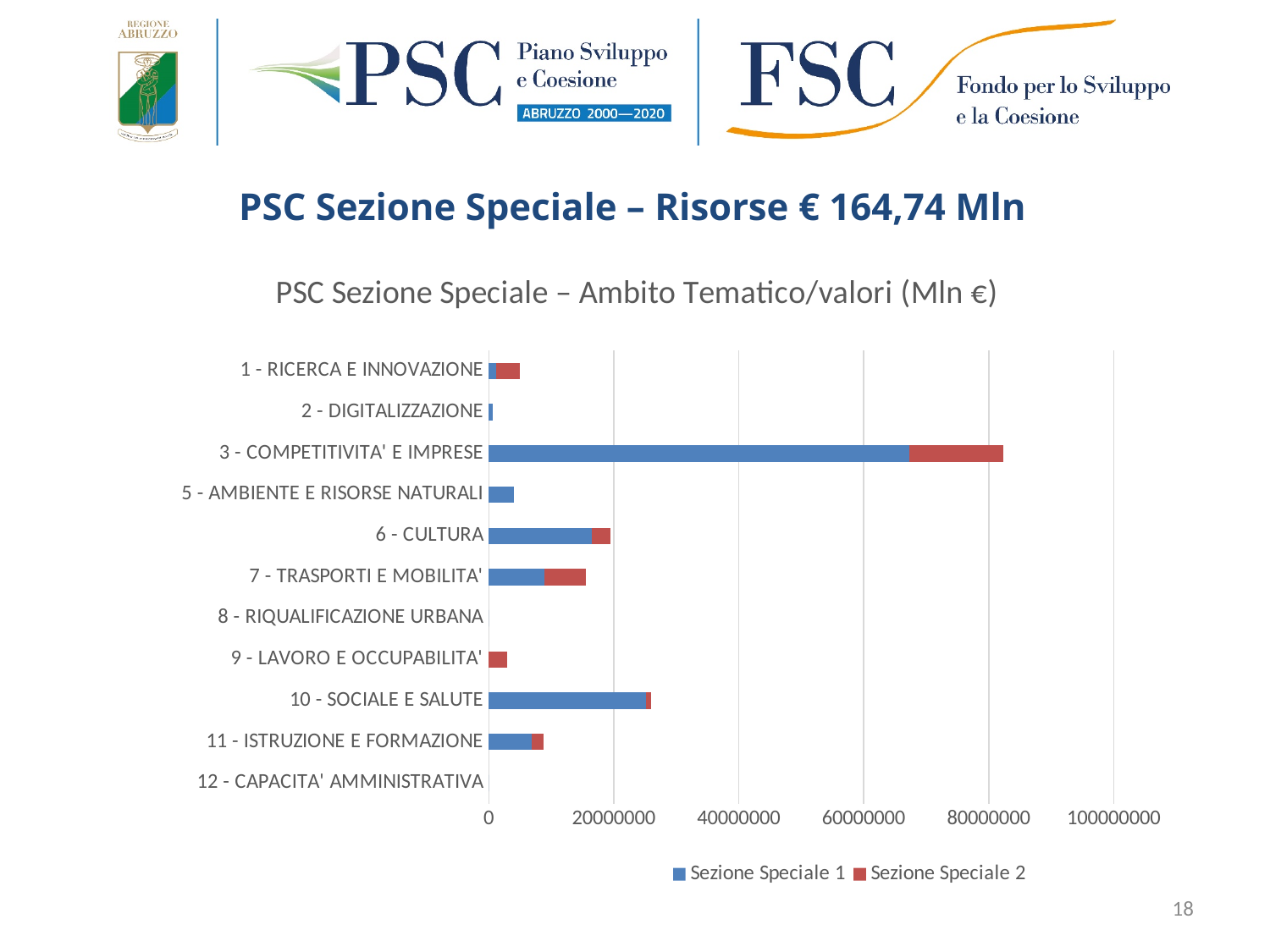
What is the title of the chart? PSC Sezione Speciale – Ambito Tematico/valori (Mln €) How many series does the chart legend list? 2 What kind of chart is shown on the slide? Stacked horizontal bar chart Is the Sezione Speciale 1 value for 3 - COMPETITIVITA' E IMPRESE greater or less than 60000000? greater Is the total value for 7 - TRASPORTI E MOBILITA' greater or less than 20000000? less Which has the larger total bar, 6 - CULTURA or 1 - RICERCA E INNOVAZIONE? 6 - CULTURA Is the total value for 3 - COMPETITIVITA' E IMPRESE greater or less than 60000000? greater Which has the larger total bar, 10 - SOCIALE E SALUTE or 7 - TRASPORTI E MOBILITA'? 10 - SOCIALE E SALUTE What are the two series named in the legend? Sezione Speciale 1 and Sezione Speciale 2 How many categories (ambiti tematici) are listed on the vertical axis of the chart? 11 Which category has the longest total bar? 3 - COMPETITIVITA' E IMPRESE